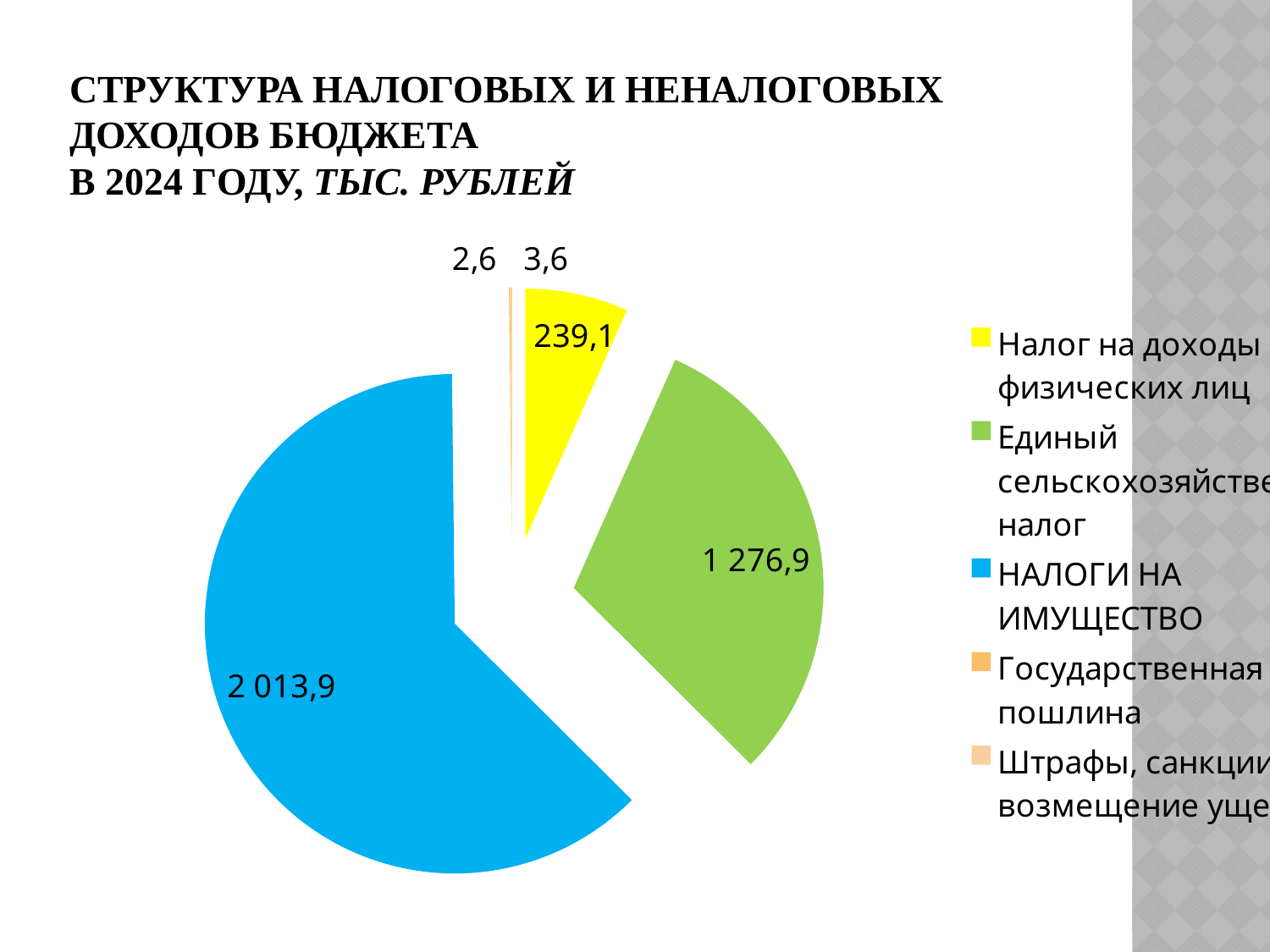
Which is larger: Единый сельскохозяйственный налог or Налог на доходы физических лиц? Единый сельскохозяйственный налог How many slices does the pie chart have? 5 Which category has the largest slice of the pie? НАЛОГИ НА ИМУЩЕСТВО What colour is the slice for НАЛОГИ НА ИМУЩЕСТВО? Blue What is the difference between the values for НАЛОГИ НА ИМУЩЕСТВО and Единый сельскохозяйственный налог? 737,0 What is the value for Единый сельскохозяйственный налог? 1 276,9 How many entries does the legend list? 5 What is the value for Налог на доходы физических лиц? 239,1 In what units are the values on the chart given, according to the title? тыс. рублей What kind of chart is shown on the slide? Pie chart What is the value for НАЛОГИ НА ИМУЩЕСТВО? 2 013,9 What is the difference between the values for Единый сельскохозяйственный налог and Налог на доходы физических лиц? 1 037,8